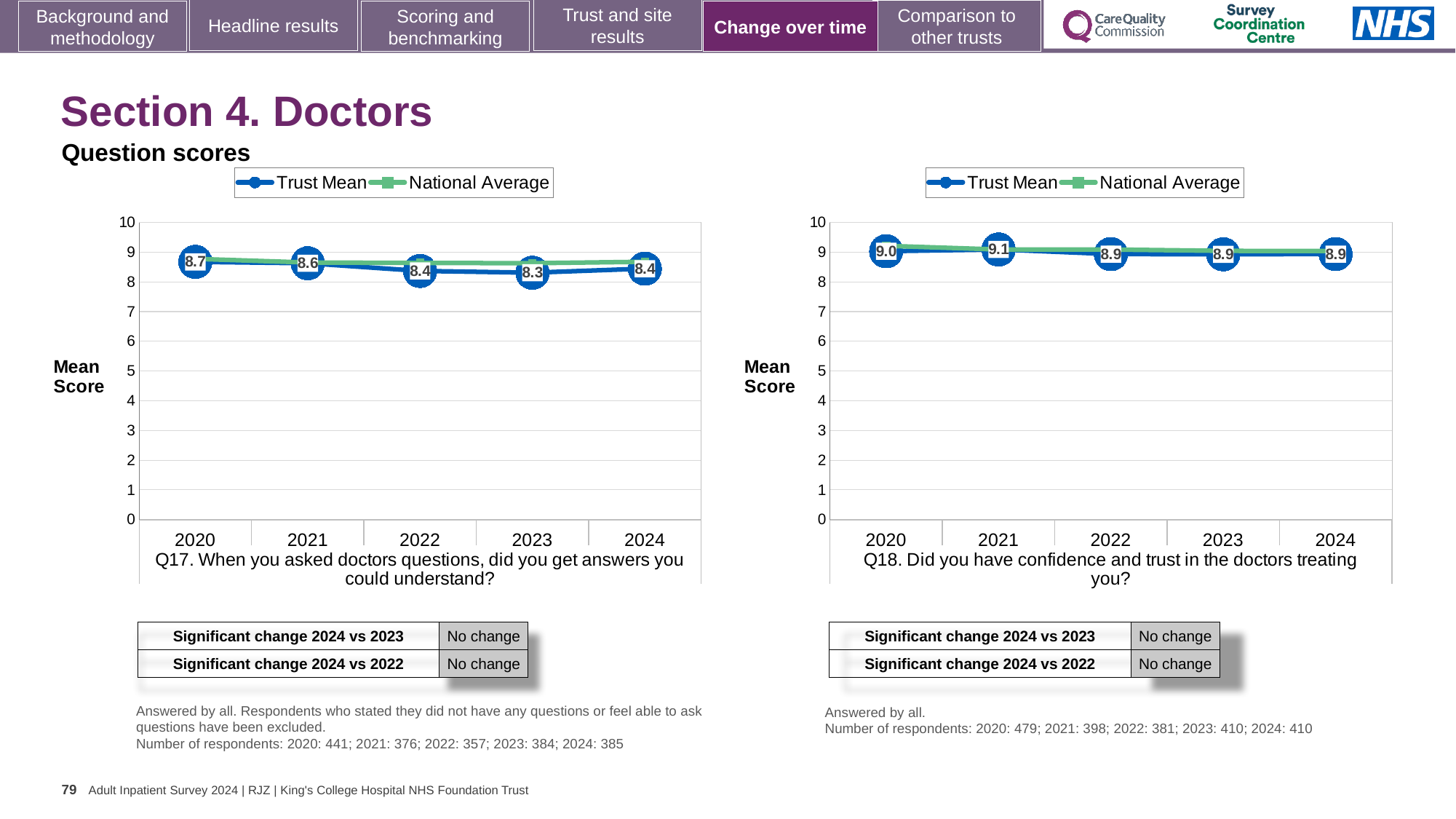
How many series does the legend of the Q18 chart on the right list? 2 How many years are shown on the x axis of the Q17 chart on the left? 5 In the Q17 chart on the left, which year has the lowest Trust Mean score? 2023 In the Q18 chart on the right, what is the difference between the Trust Mean scores for 2021 and 2024? 0.2 In the Q18 chart on the right, is the National Average value for 2024 greater or less than 8? greater In the Q17 chart on the left, which year has the highest Trust Mean score? 2020 In the Q18 chart on the right, which year has the highest Trust Mean score? 2021 In the Q17 chart on the left, is the Trust Mean score higher in 2020 or in 2024? 2020 In the Q18 chart on the right, what is the Trust Mean score for 2021? 9.1 In the Q17 chart on the left, what is the difference between the Trust Mean scores for 2020 and 2023? 0.4 In the Q17 chart on the left, what is the Trust Mean score for 2020? 8.7 What type of chart is the Q17 chart on the left? Line chart